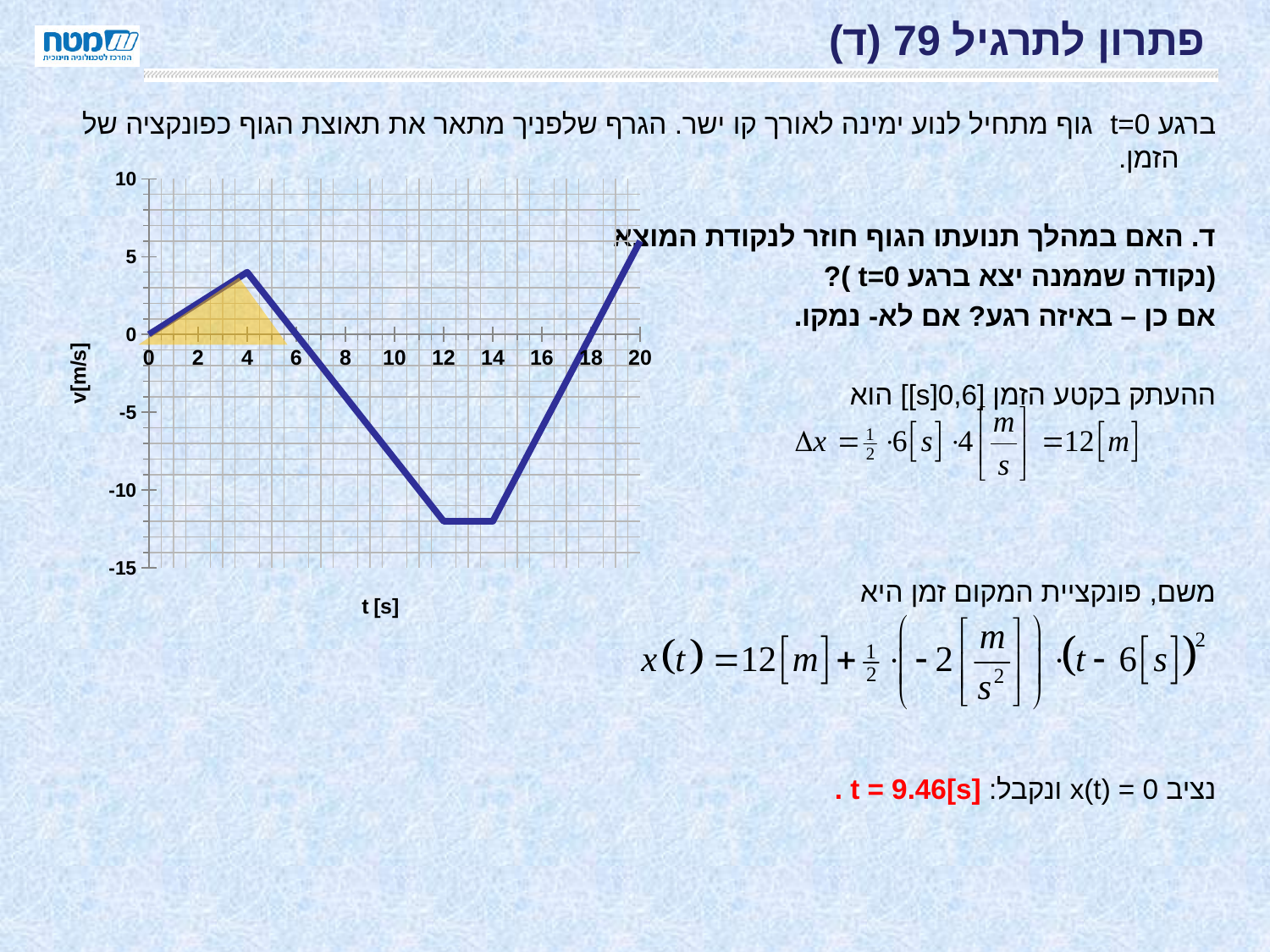
Does the velocity rise or fall between t = 14 s and t = 20 s? rise What is the label of the horizontal axis of the chart? t [s] Is the velocity at t = 12 s greater or less than -10? less What is the velocity at t = 4 s? 4 Which is larger, the velocity at t = 4 s or the velocity at t = 12 s? t = 4 s What is the velocity at t = 6 s? 0 What is the velocity at t = 0 s? 0 What is the label of the vertical axis of the chart? v[m/s] Is the velocity at t = 2 s greater or less than 5? less What kind of chart is shown on the slide? line chart Does the velocity rise or fall between t = 6 s and t = 12 s? fall